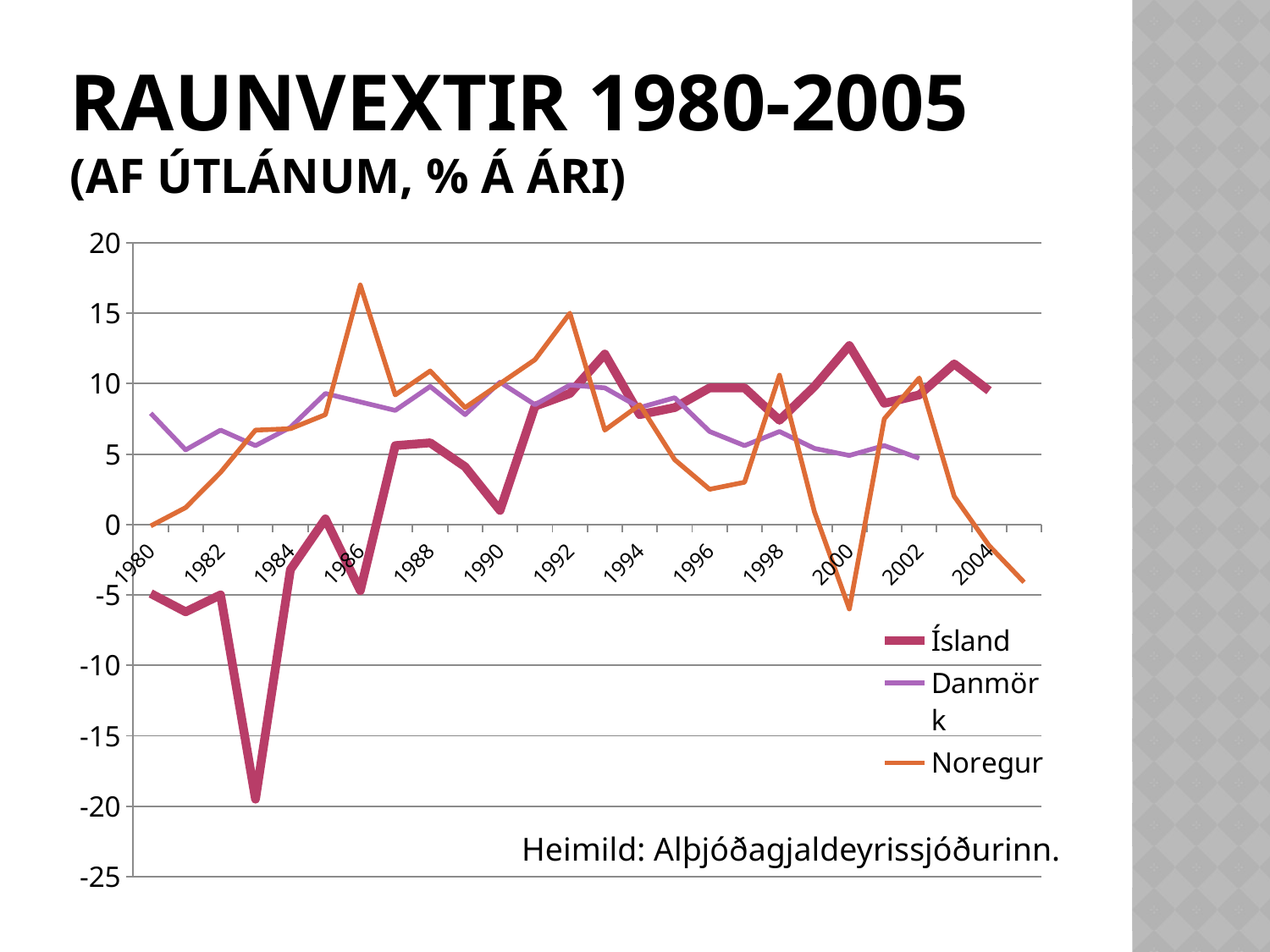
Is the value for Ísland in 1980 greater or less than 0? less Which countries are listed in the chart legend? Ísland, Danmörk, Noregur In which year does the Ísland series reach its lowest value? 1983 What is the title of the chart on the slide? RAUNVEXTIR 1980-2005 (AF ÚTLÁNUM, % Á ÁRI) Is the value for Noregur in 1986 greater or less than 15? greater Does the Noregur series rise or fall between 1998 and 2000? fall How many series does the legend list? 3 In which year does the Noregur series reach its highest value? 1986 What kind of chart is shown on the slide? line chart Which series reaches the lowest value anywhere on the chart? Ísland Is the value for Ísland in 1983 greater or less than -15? less In 1986, which series has the larger value, Noregur or Ísland? Noregur